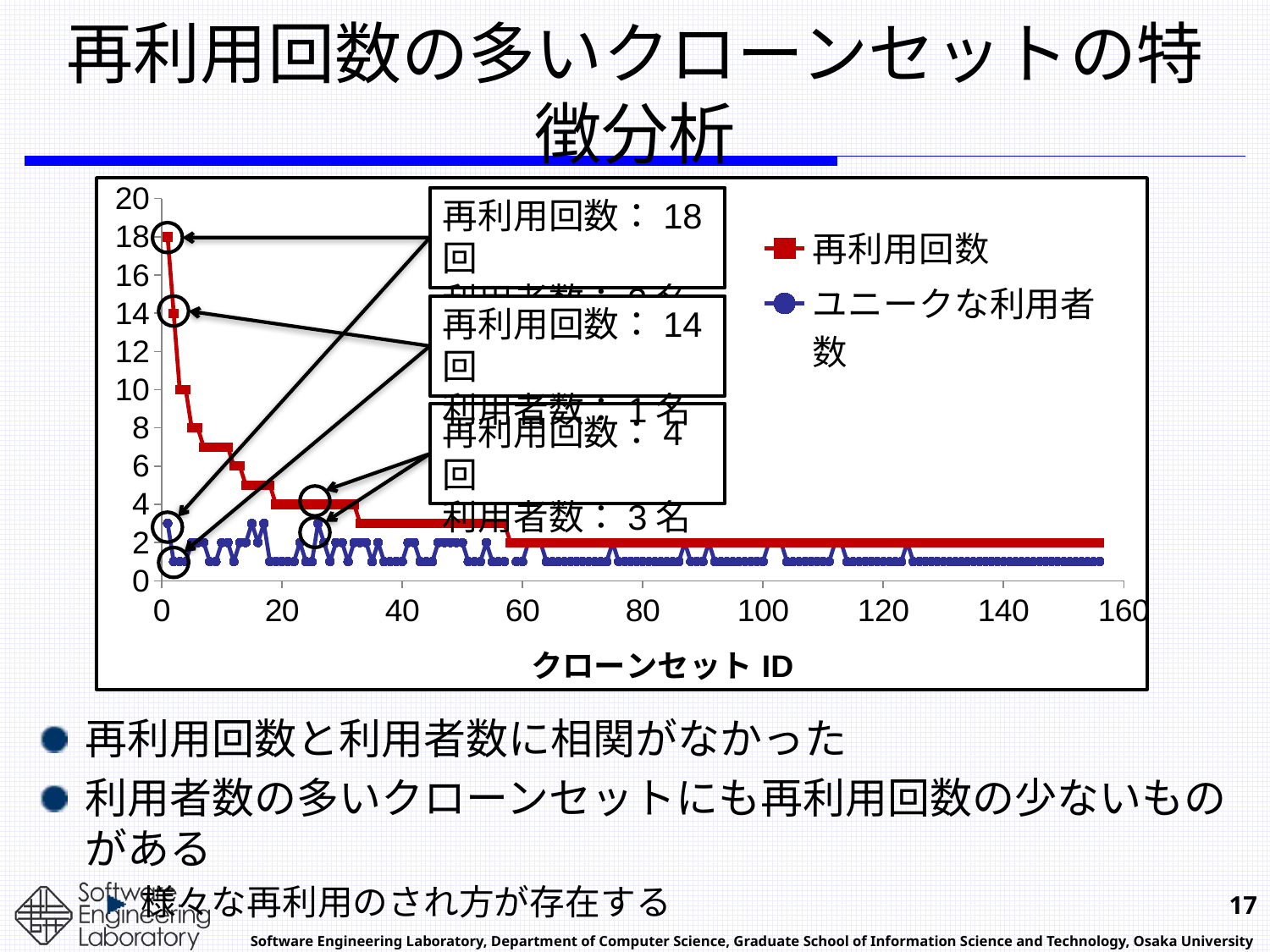
What is the highest value of 再利用回数 shown on the chart, according to the annotation? 18回 What kind of chart is shown on the slide? line chart According to the annotation for the clone set with 再利用回数 of 4回, how many 利用者数 does it have? 3名 What are the two series named in the legend? 再利用回数 and ユニークな利用者数 According to the annotation for the clone set with 再利用回数 of 14回, how many 利用者数 does it have? 1名 Is the value of 再利用回数 at クローンセット ID 100 greater or less than 10? less Does the 再利用回数 series rise or fall as クローンセット ID increases? fall What is the title of the x axis? クローンセット ID What is the difference between the annotated 再利用回数 values of 18回 and 14回? 4回 Is the value of ユニークな利用者数 at クローンセット ID 140 greater or less than 4? less How many series does the legend list? 2 At クローンセット ID 1, which series has the larger value, 再利用回数 or ユニークな利用者数? 再利用回数